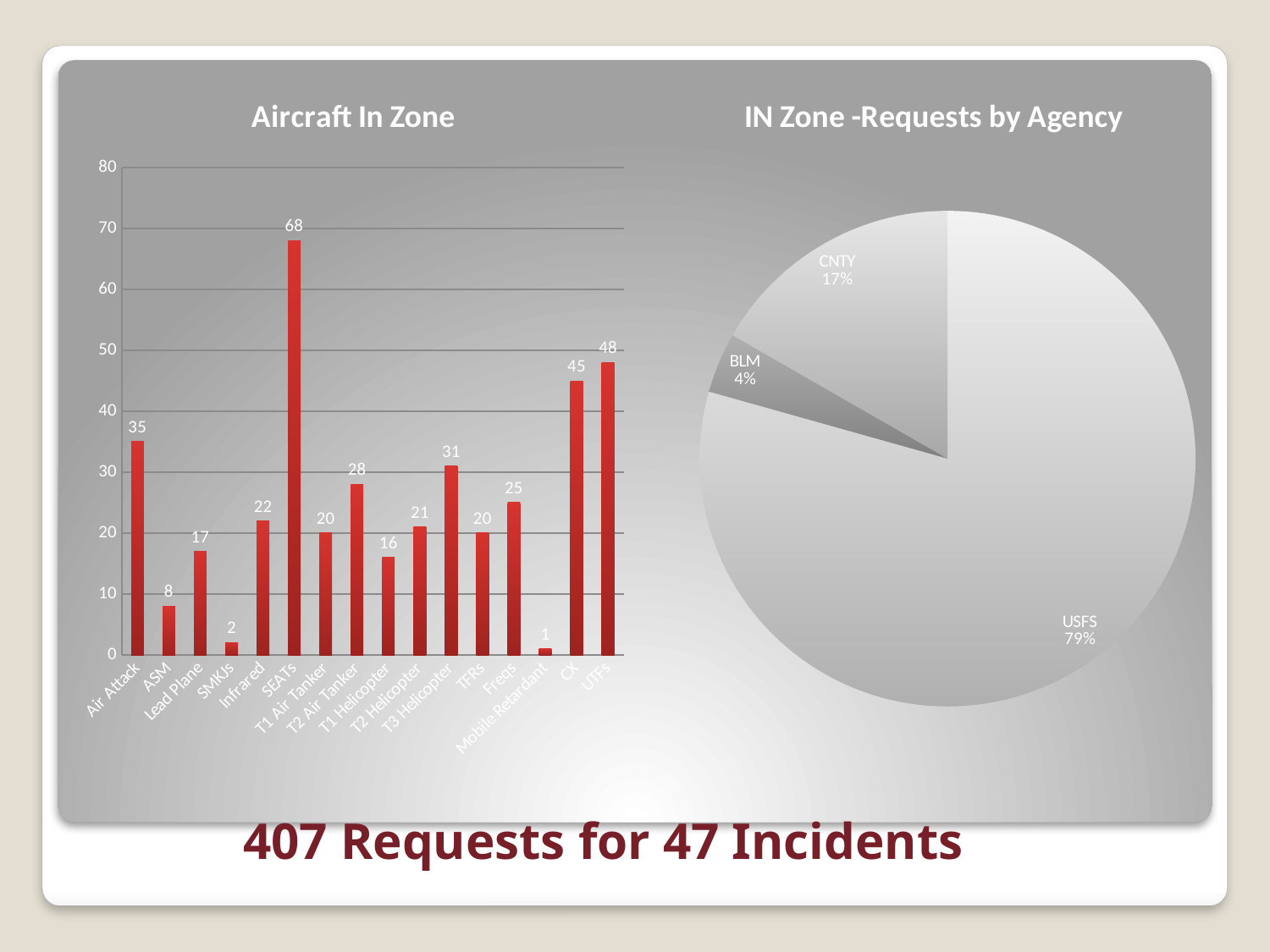
In the Aircraft In Zone chart, how many categories are shown on the x axis? 16 What kind of chart is the Aircraft In Zone chart? Bar chart In the IN Zone -Requests by Agency chart, what share of requests is from USFS? 79% In the Aircraft In Zone chart, which is larger, the value for Air Attack or the value for T2 Air Tanker? Air Attack In the Aircraft In Zone chart, what is the value for T3 Helicopter? 31 In the Aircraft In Zone chart, which category has the lowest value? Mobile Retardant In the Aircraft In Zone chart, what is the difference between the values for UTFs and CX? 3 What kind of chart is the IN Zone -Requests by Agency chart? Pie chart In the Aircraft In Zone chart, which category has the highest value? SEATs In the IN Zone -Requests by Agency chart, how many slices does the pie have? 3 In the Aircraft In Zone chart, what is the value for SEATs? 68 In the IN Zone -Requests by Agency chart, which agency has the smallest slice? BLM